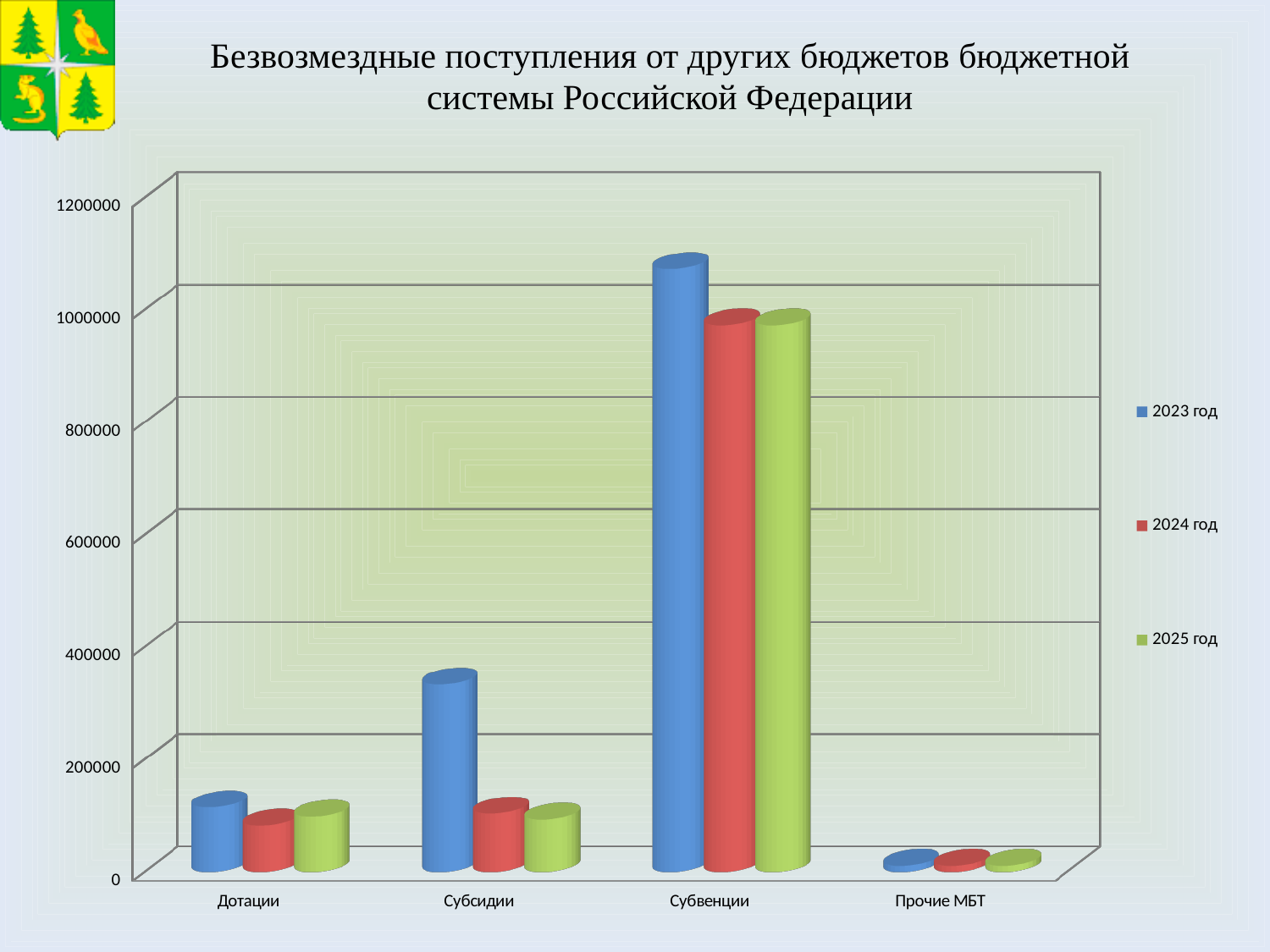
Is the value for Субсидии in 2023 год greater or less than 400000? less For Субсидии, which is larger: the value for 2023 год or the value for 2024 год? 2023 год Is the value for Дотации in 2023 год greater or less than 200000? less Which series is shown in green in the legend? 2025 год Which category has the lowest value for 2025 год? Прочие МБТ Which category has the highest value for 2023 год? Субвенции Is the value for Субвенции in 2023 год greater or less than 1000000? greater How many series does the legend list? 3 What kind of chart is shown on the slide? bar chart For Субвенции, which is larger: the value for 2023 год or the value for 2024 год? 2023 год How many categories are shown on the x axis? 4